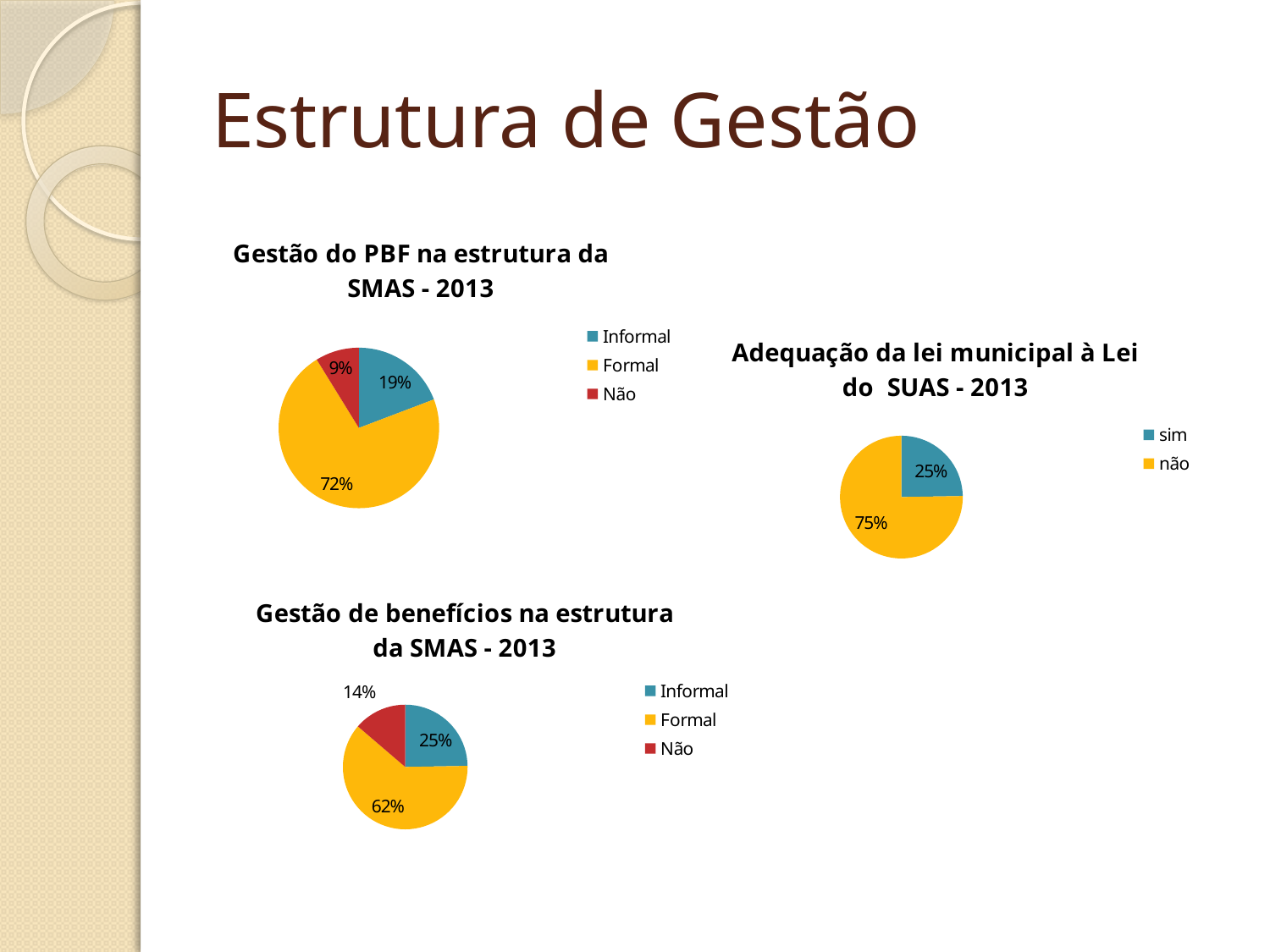
In the chart 'Gestão do PBF na estrutura da SMAS - 2013', what is the difference between the Formal and Informal shares? 53% How many categories are shown in the chart 'Gestão de benefícios na estrutura da SMAS - 2013'? 3 How many series does the legend list in the chart 'Adequação da lei municipal à Lei do SUAS - 2013'? 2 In the chart 'Gestão do PBF na estrutura da SMAS - 2013', what share of the pie is Formal? 72% In the chart 'Gestão do PBF na estrutura da SMAS - 2013', which category has the smallest slice? Não In the chart 'Adequação da lei municipal à Lei do SUAS - 2013', what is the value for sim? 25% In the chart 'Gestão de benefícios na estrutura da SMAS - 2013', which is larger, Informal or Não? Informal In the chart 'Gestão de benefícios na estrutura da SMAS - 2013', what is the difference between the Formal and Não shares? 48% In the chart 'Adequação da lei municipal à Lei do SUAS - 2013', which category has the largest slice? não In the chart 'Gestão do PBF na estrutura da SMAS - 2013', what is the value for Informal? 19% In the chart 'Gestão de benefícios na estrutura da SMAS - 2013', what is the value for Não? 14% What kind of chart is 'Gestão do PBF na estrutura da SMAS - 2013'? Pie chart